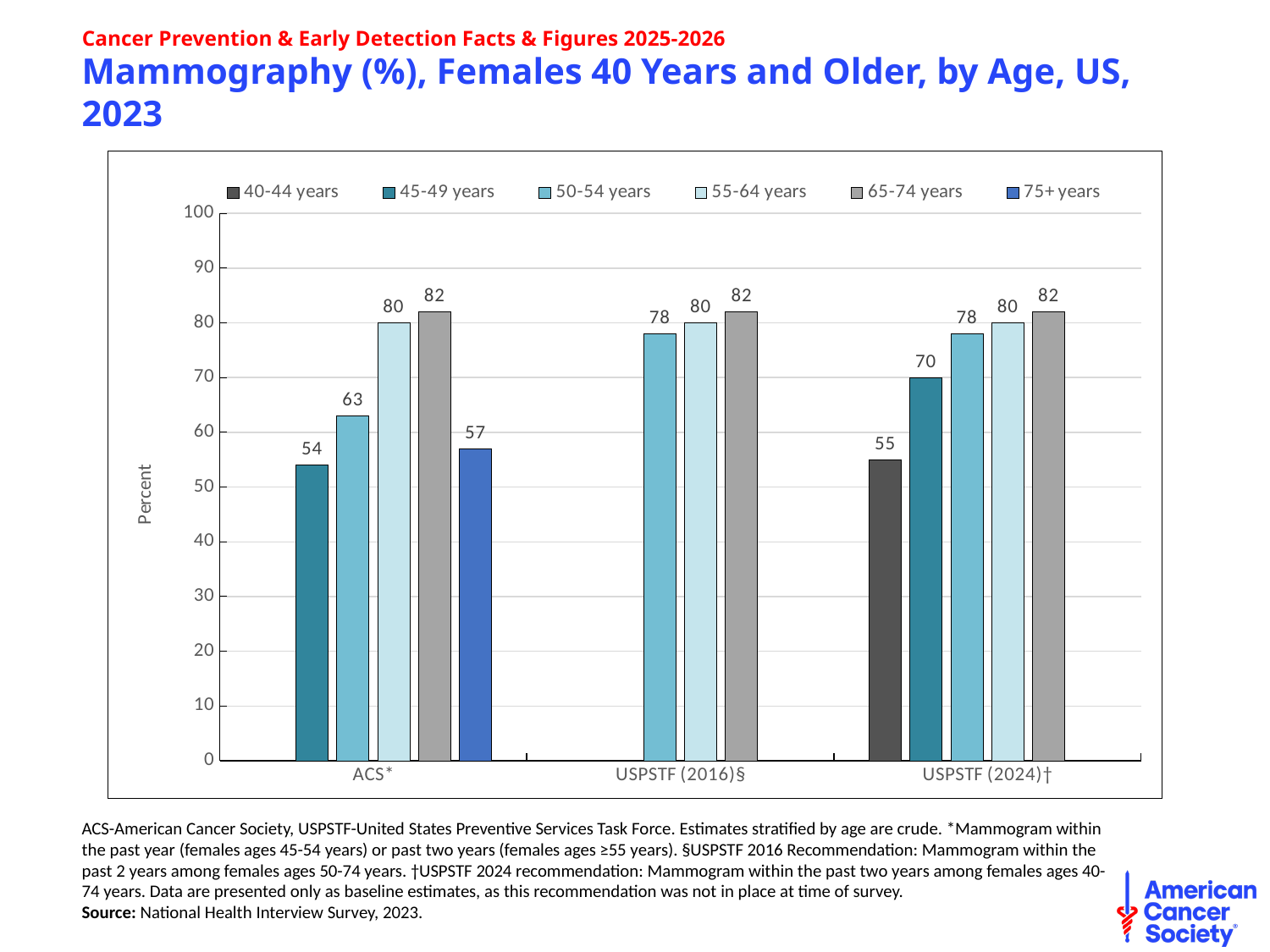
Which is larger in the USPSTF (2024)† group: the value for 40-44 years or the value for 45-49 years? 45-49 years What kind of chart is shown on the slide? Bar chart What is the value for 45-49 years in the ACS* group? 54 Which age group has the highest value in the USPSTF (2016)§ group? 65-74 years What is the value for 75+ years in the ACS* group? 57 What is the value for 40-44 years in the USPSTF (2024)† group? 55 What is the label of the y axis? Percent How many category groups are shown on the x axis? 3 How many series does the legend list? 6 Which age group has the lowest value in the ACS* group? 45-49 years What is the value for 45-49 years in the USPSTF (2024)† group? 70 What is the difference between the 65-74 years value and the 45-49 years value in the ACS* group? 28